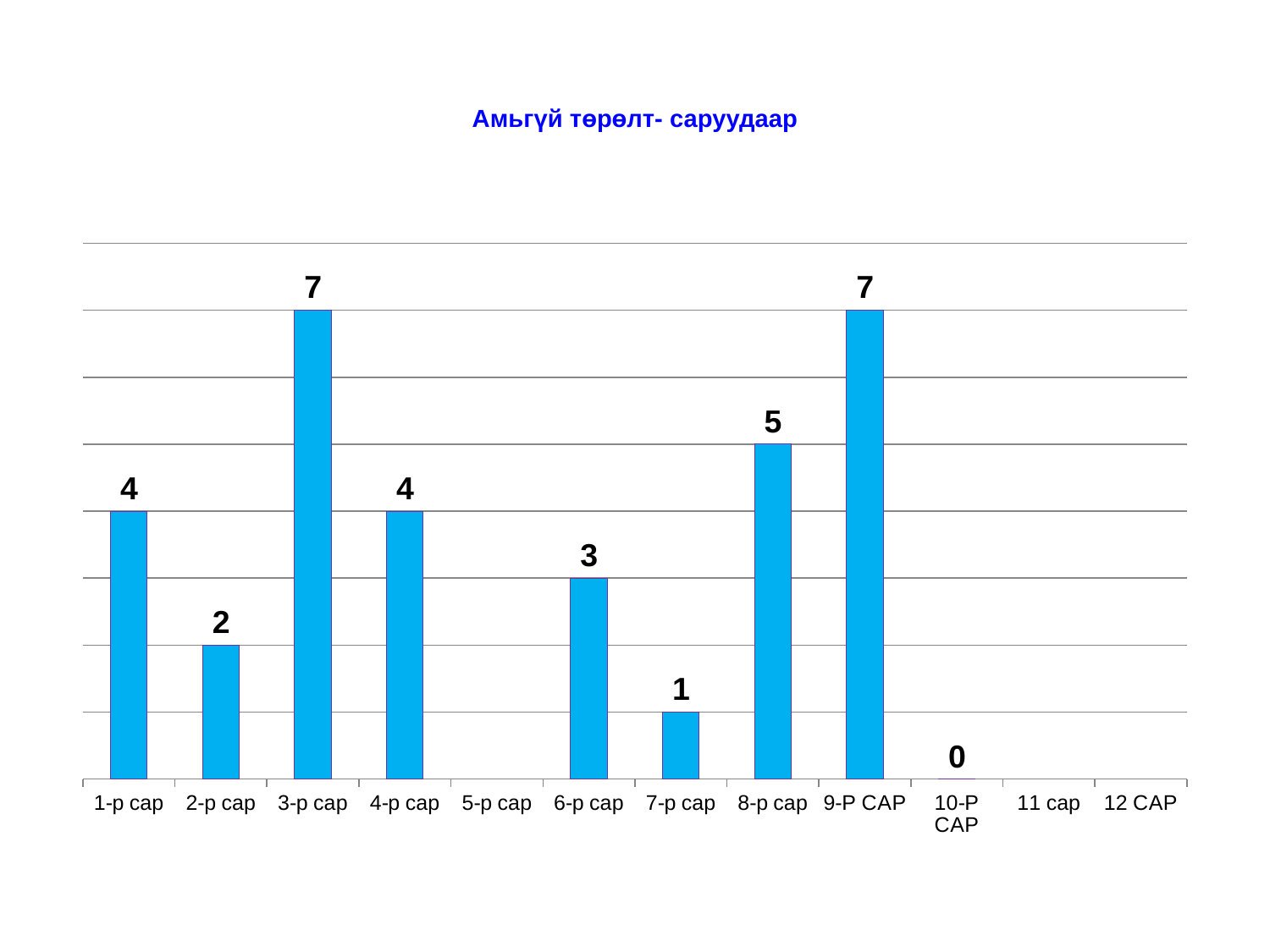
What is the value for 10-Р САР? 0 What kind of chart is shown on the slide? Bar chart What is the value for 1-р сар? 4 Which category has the lowest labelled value? 10-Р САР What is the value for 3-р сар? 7 What is the value for 7-р сар? 1 How many categories are shown on the x axis? 12 Which is larger, the value for 8-р сар or the value for 6-р сар? 8-р сар What is the value for 8-р сар? 5 What is the title of the chart? Амьгүй төрөлт- саруудаар What is the highest value shown on the chart? 7 What is the difference between the values for 3-р сар and 2-р сар? 5